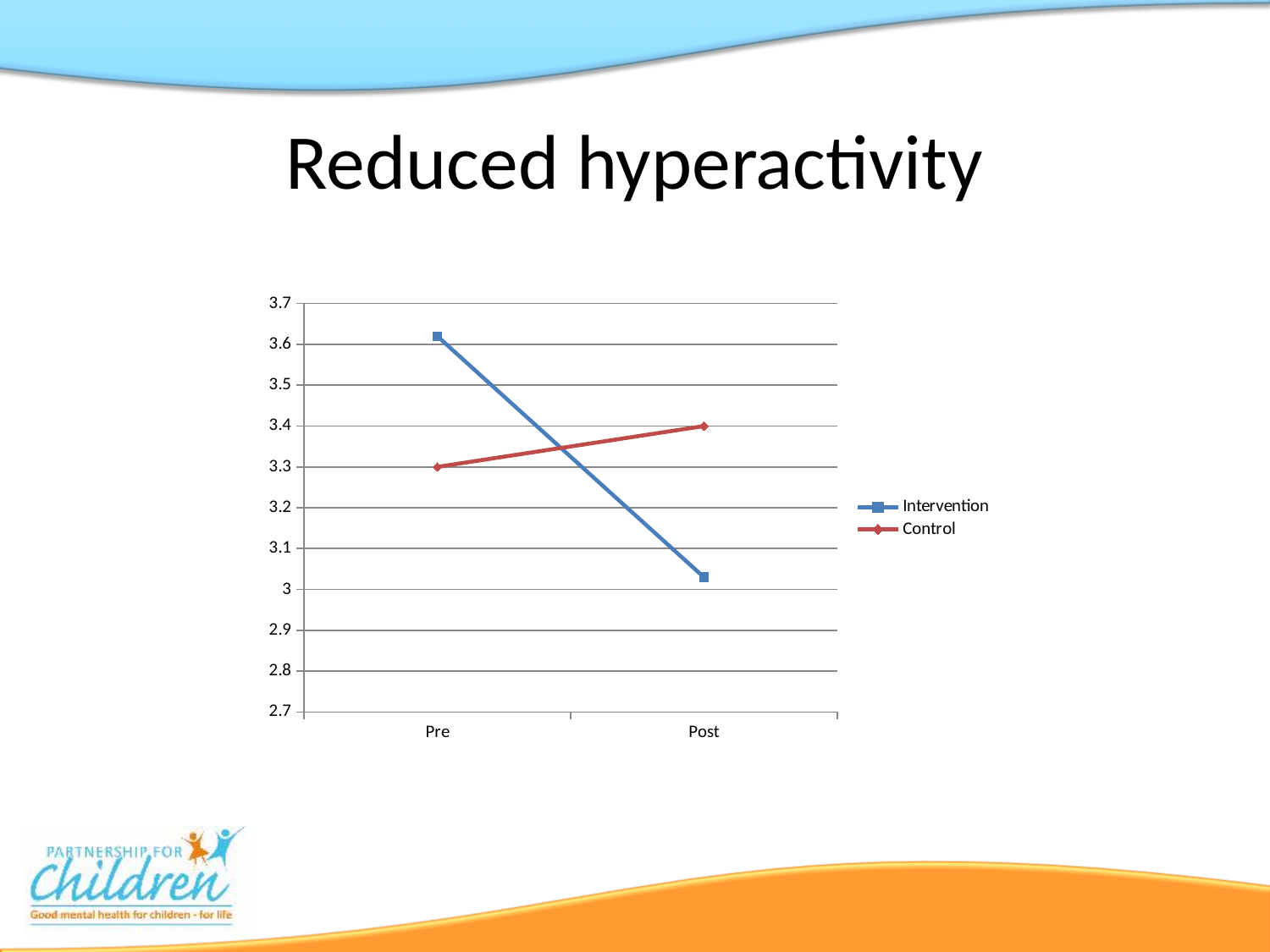
What is the Control value at Pre? 3.3 What is the title of the slide containing the chart? Reduced hyperactivity Does the Intervention line rise or fall from Pre to Post? fall What kind of chart is shown on the slide? line chart How many points are there along the x axis? 2 At Post, which series has the higher value, Intervention or Control? Control At Pre, which series has the higher value, Intervention or Control? Intervention What is the Control value at Post? 3.4 How many series does the legend list? 2 Is the Intervention value at Pre greater or less than 3.5? greater Is the Intervention value at Post greater or less than 3.1? less By how much does the Control value change from Pre to Post? 0.1